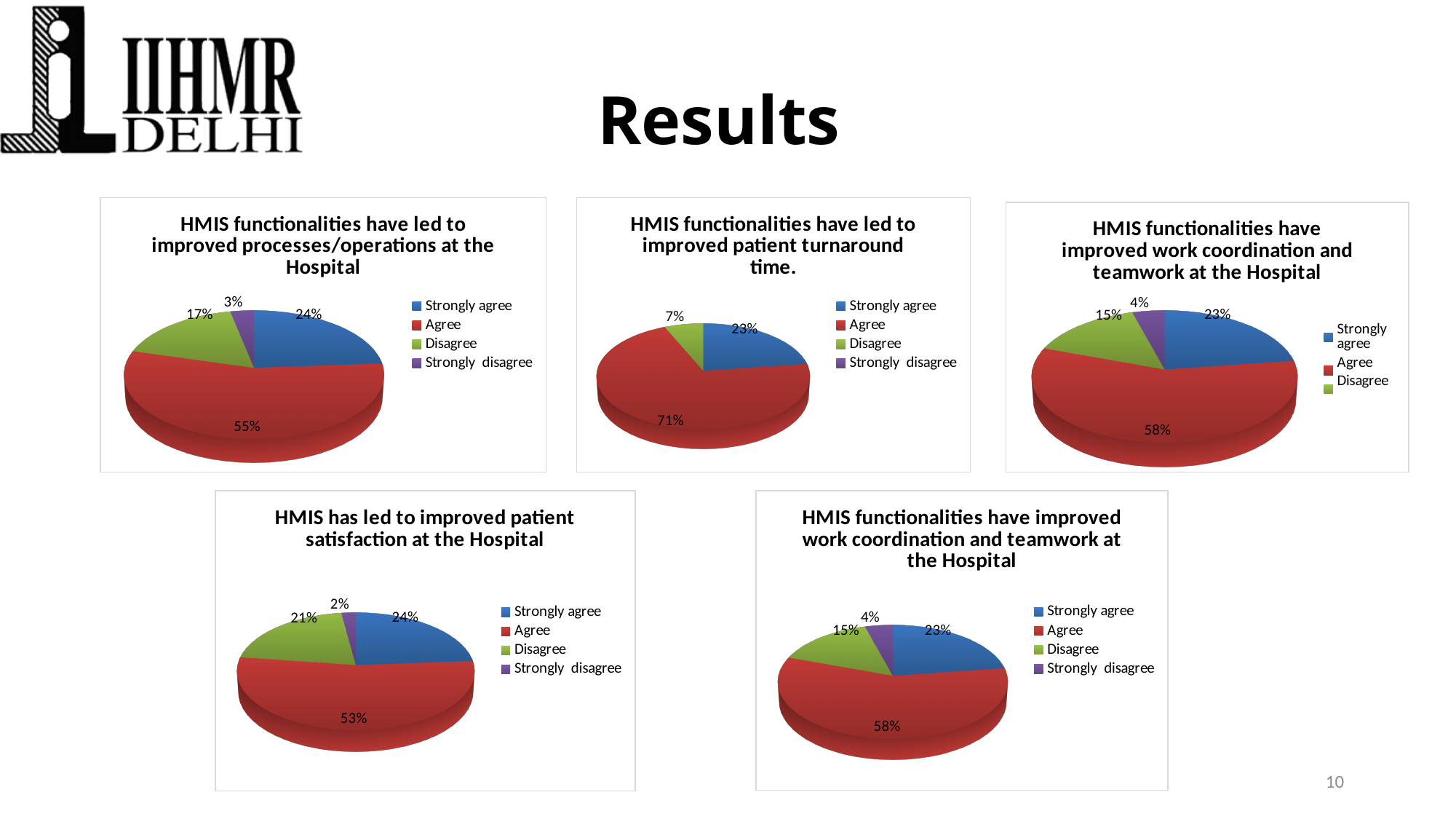
In the pie chart titled "HMIS has led to improved patient satisfaction at the Hospital", what percentage is shown for Strongly disagree? 2% In the pie chart titled "HMIS functionalities have led to improved patient turnaround time.", what percentage is shown for Disagree? 7% In the pie chart titled "HMIS functionalities have led to improved processes/operations at the Hospital", which response category has the smallest slice? Strongly disagree In the pie chart titled "HMIS functionalities have led to improved patient turnaround time.", what colour is the Agree slice? Red In the pie chart titled "HMIS functionalities have led to improved patient turnaround time.", which response category has the largest slice? Agree How many entries does the legend list in the pie chart titled "HMIS has led to improved patient satisfaction at the Hospital"? 4 In the bottom-right pie chart titled "HMIS functionalities have improved work coordination and teamwork at the Hospital", which is larger: Strongly agree or Disagree? Strongly agree In the pie chart titled "HMIS has led to improved patient satisfaction at the Hospital", what is the difference between the Agree and Strongly agree percentages? 29% In the pie chart titled "HMIS functionalities have led to improved processes/operations at the Hospital", what share of respondents chose Agree? 55% How many entries does the legend list in the top-right pie chart titled "HMIS functionalities have improved work coordination and teamwork at the Hospital"? 3 What type of chart is used for "HMIS has led to improved patient satisfaction at the Hospital"? Pie chart How many pie charts are shown on the slide? 5